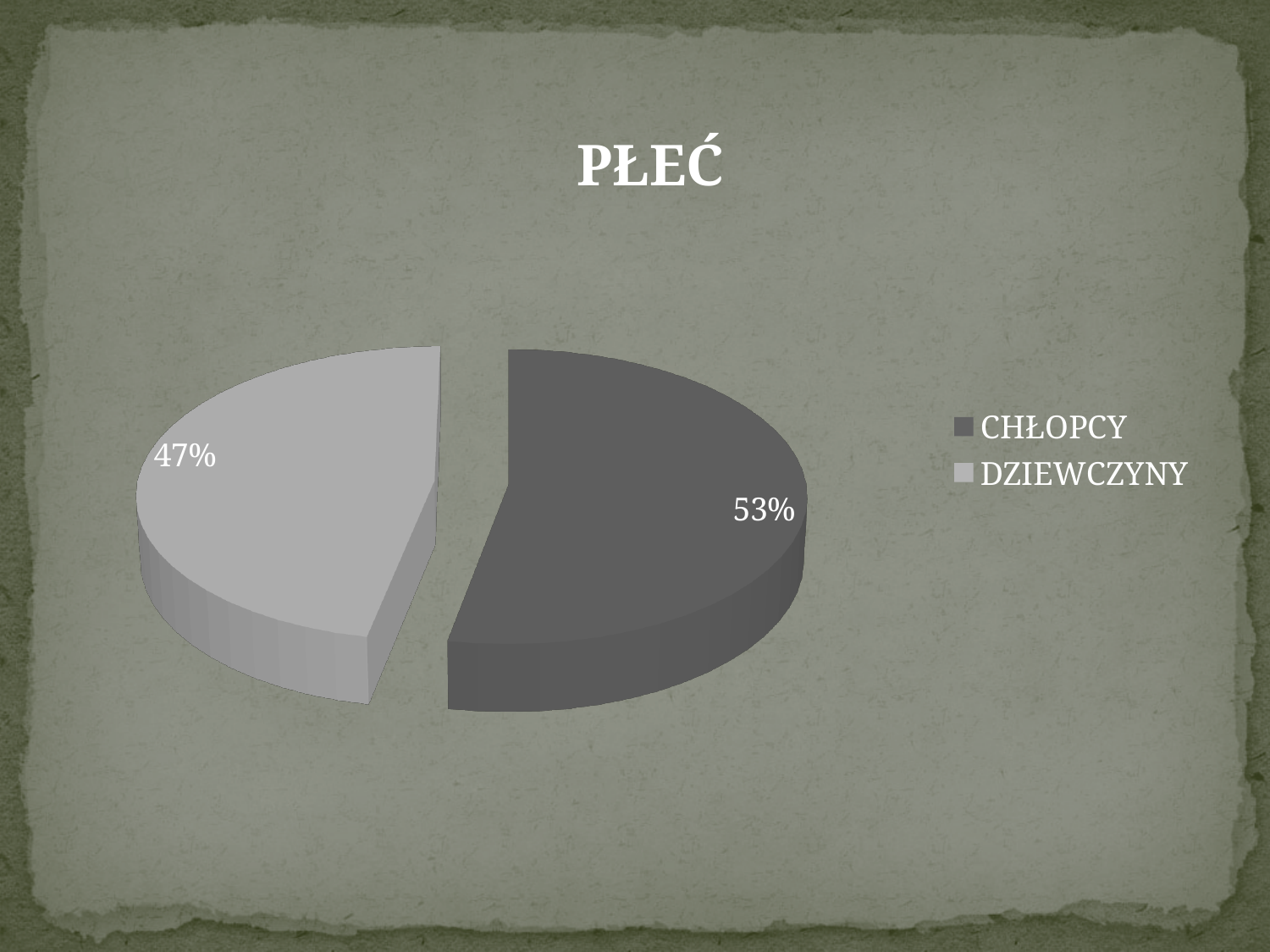
Which category has the largest share of the pie? CHŁOPCY What is the difference in percentage points between the CHŁOPCY and DZIEWCZYNY shares? 6% What share of the pie does CHŁOPCY represent? 53% Which is larger, the share for CHŁOPCY or the share for DZIEWCZYNY? CHŁOPCY Which category has the smallest share of the pie? DZIEWCZYNY How many entries does the legend list? 2 Is the share for DZIEWCZYNY greater or less than 50%? less What share of the pie does DZIEWCZYNY represent? 47% Which category is shown in the lighter grey colour? DZIEWCZYNY How many slices does the pie chart have? 2 What type of chart is shown on the slide? pie chart What is the title of the chart? PŁEĆ